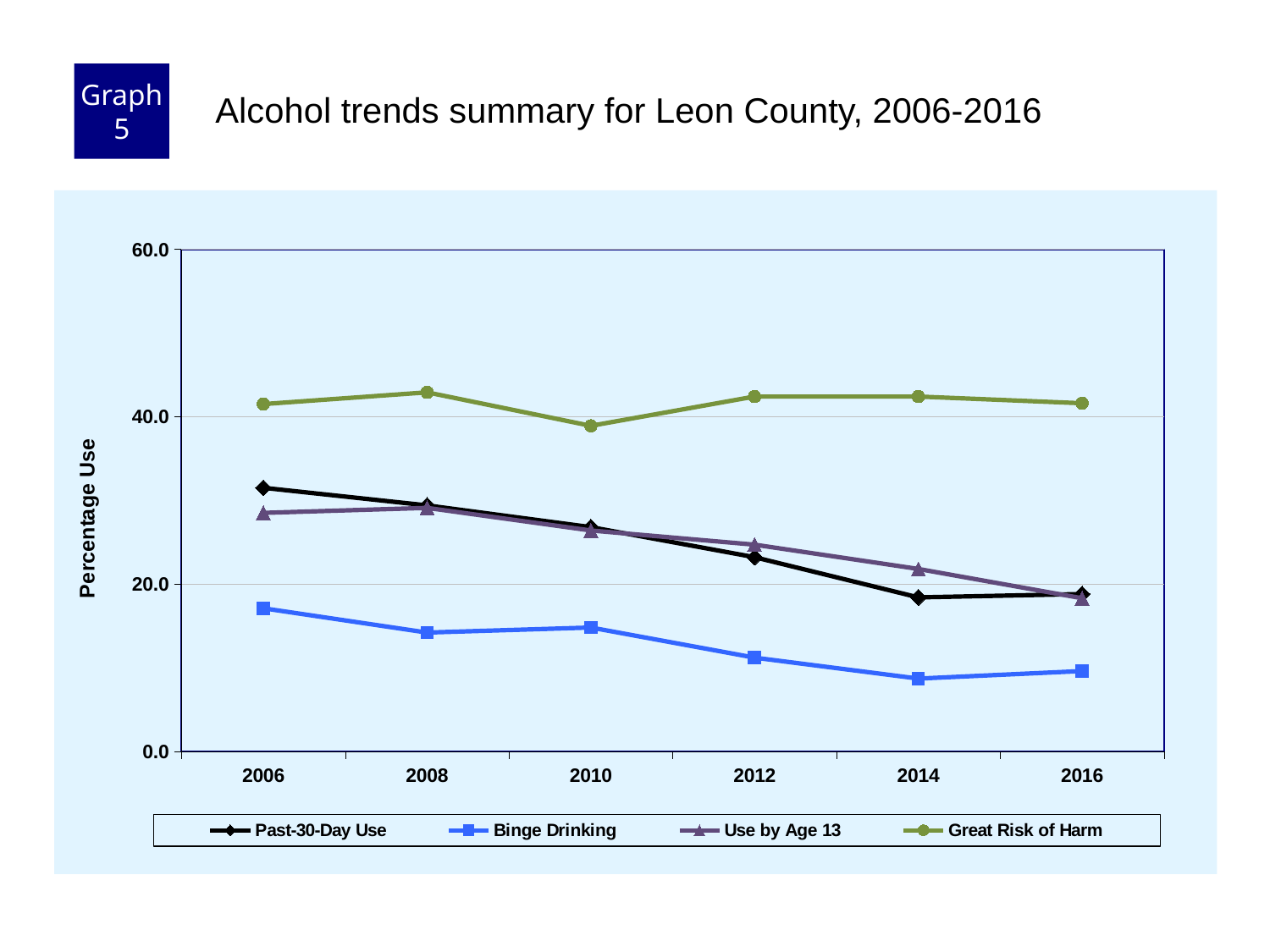
Which series has the lowest values across all years? Binge Drinking In 2014, which is larger: Use by Age 13 or Past-30-Day Use? Use by Age 13 Is the value for Great Risk of Harm in 2008 greater or less than 40.0? greater Is the value for Binge Drinking in 2014 greater or less than 20.0? less In which year is Past-30-Day Use highest? 2006 How many years are plotted along the x axis? 6 Is the value for Past-30-Day Use in 2006 greater or less than 20.0? greater Does Binge Drinking generally rise or fall from 2006 to 2016? fall What is the label on the y axis? Percentage Use Which series has the highest values across all years? Great Risk of Harm What kind of chart is shown on the slide? line chart How many series does the legend list? 4